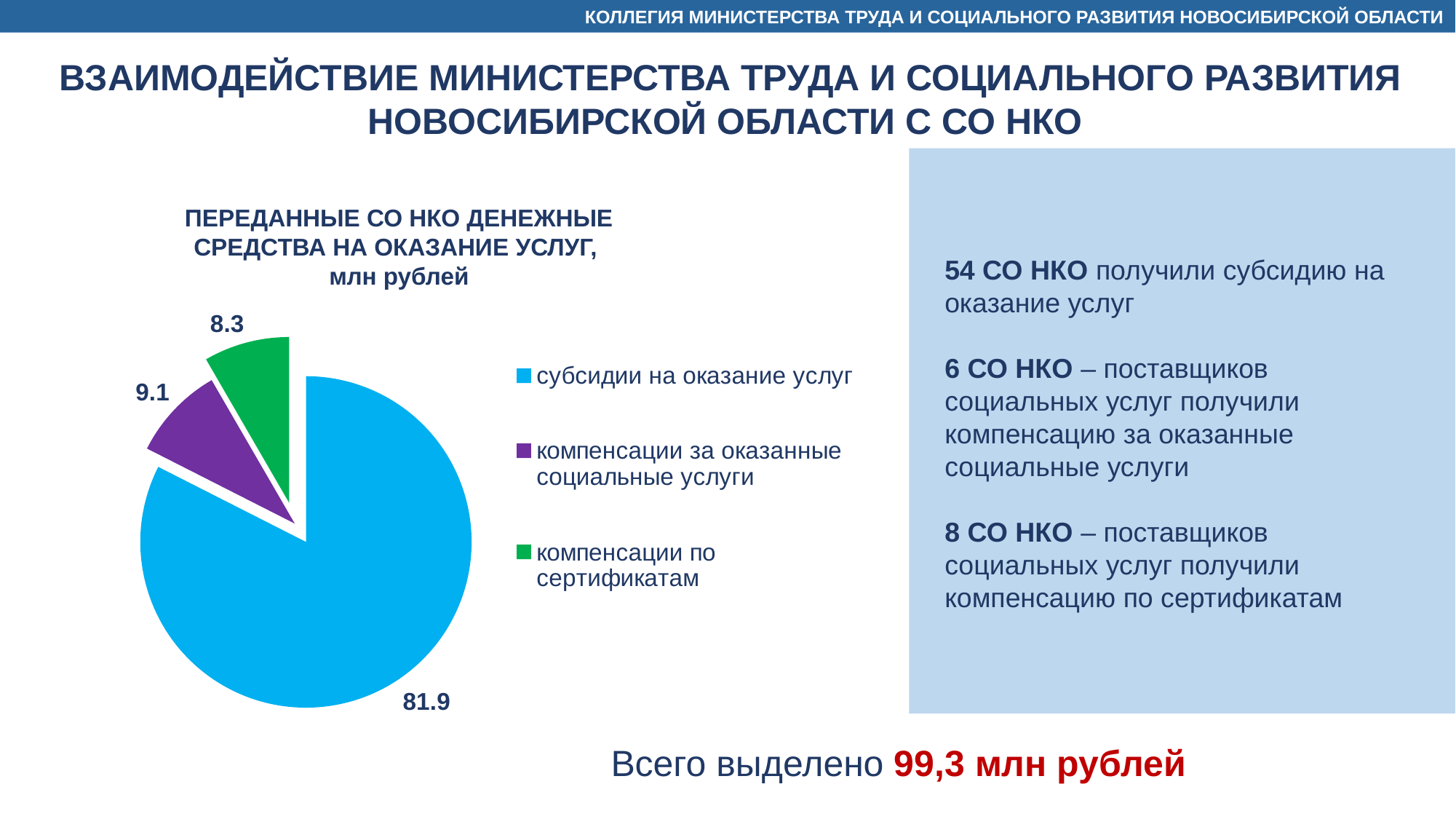
What colour is the slice for «компенсации по сертификатам»? Green What is the difference between the values for «компенсации за оказанные социальные услуги» and «компенсации по сертификатам»? 0.8 What is the value for «компенсации за оказанные социальные услуги» in the pie chart? 9.1 What is the total of all slices in the pie chart, in million rubles? 99.3 What type of chart is shown on the slide? Pie chart What is the value for «субсидии на оказание услуг» in the pie chart? 81.9 Which is larger: the value for «компенсации за оказанные социальные услуги» or for «компенсации по сертификатам»? компенсации за оказанные социальные услуги Which category has the largest slice in the pie chart? субсидии на оказание услуг What is the value for «компенсации по сертификатам» in the pie chart? 8.3 How many slices does the pie chart have? 3 What is the difference between the values for «субсидии на оказание услуг» and «компенсации за оказанные социальные услуги»? 72.8 Which category has the smallest slice in the pie chart? компенсации по сертификатам